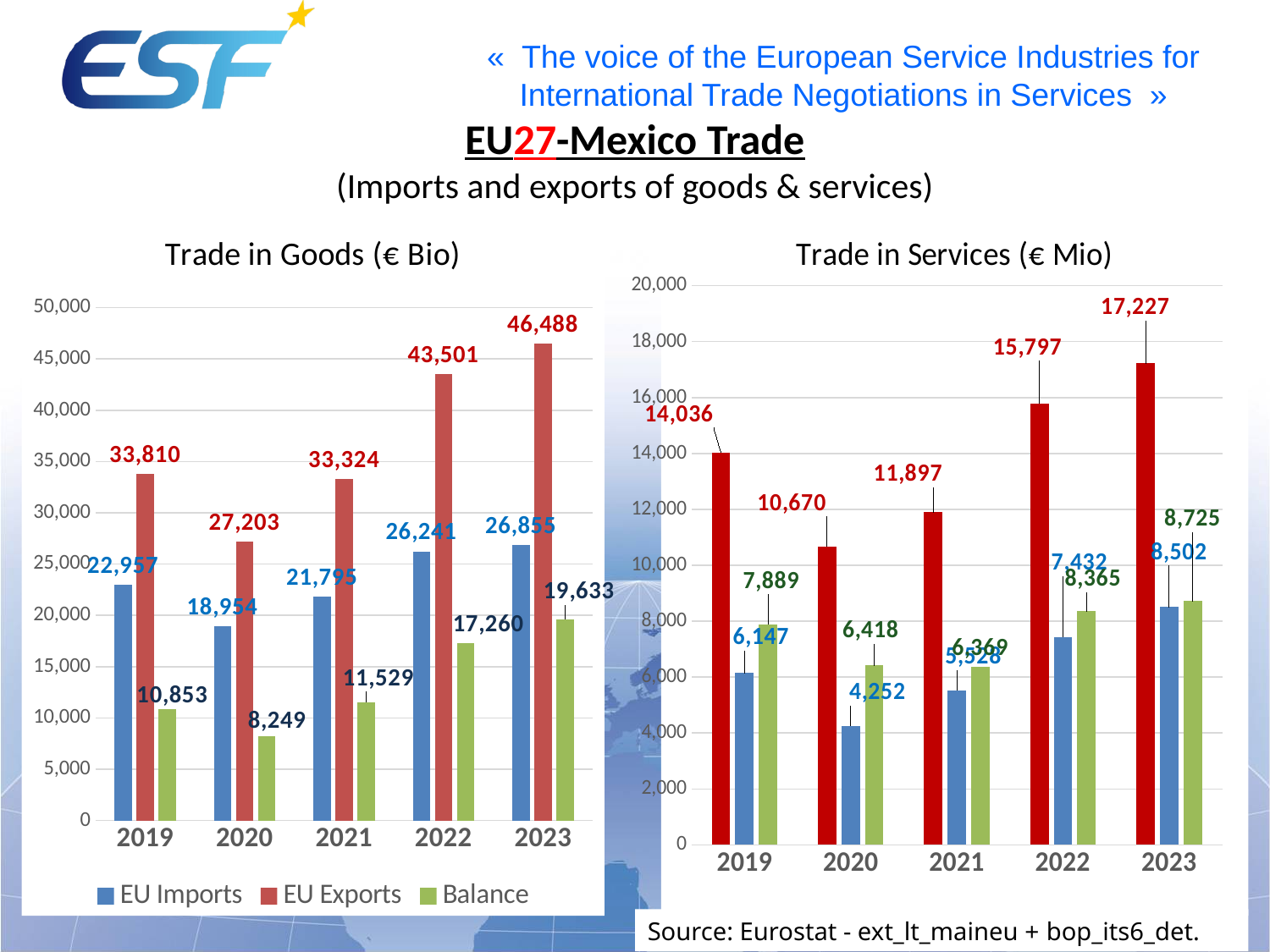
How many series does the legend of the Trade in Goods chart list? 3 How many years are shown on the x axis of the Trade in Goods chart? 5 In the Trade in Services chart, do the red bars rise or fall from 2020 to 2023? rise In the Trade in Services chart, what is the value of the green bar for 2023? 8,725 In the Trade in Goods chart, what is the Balance value for 2020? 8,249 In the Trade in Goods chart, by how much did EU Exports increase from 2022 to 2023? 2,987 In the Trade in Goods chart, which year has the lowest EU Exports value? 2020 In the Trade in Services chart, what is the value of the red bar for 2021? 11,897 What kind of chart is the Trade in Services chart? bar chart In the Trade in Goods chart, is the EU Imports value larger in 2019 or in 2021? 2019 In the Trade in Goods chart, which year has the highest EU Imports value? 2023 In the Trade in Goods chart, what is the value of EU Exports for 2022? 43,501